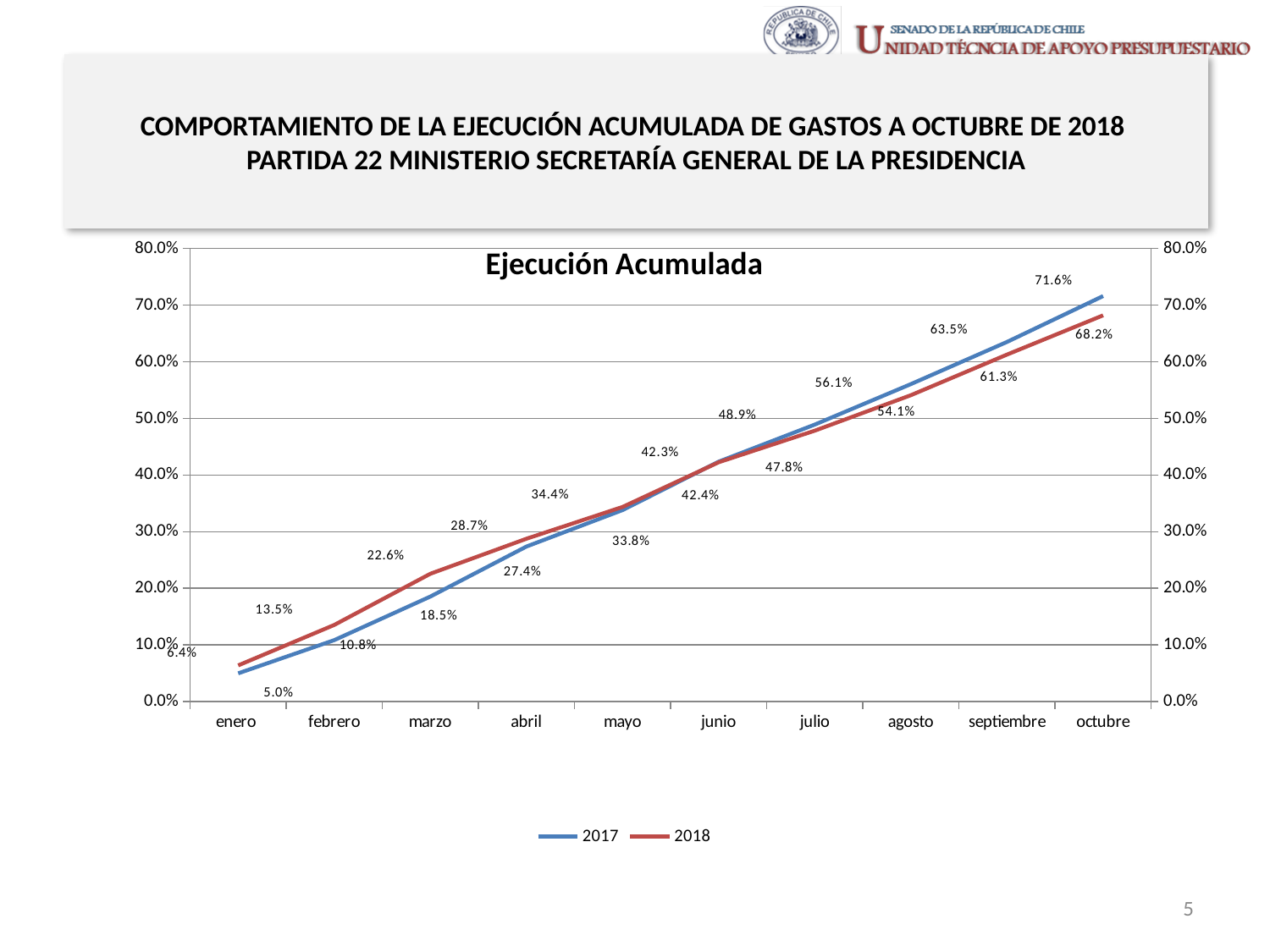
What is the lowest value labeled on the chart? 5.0% Is the value for 2017 in abril greater or less than 30%? less In enero, which series has the larger value, 2017 or 2018? 2018 How many months are plotted along the x axis? 10 How many series does the legend list? 2 What is the title of the chart? Ejecución Acumulada Which month has the lowest values for both series? enero Which series are listed in the legend? 2017 and 2018 What is the highest value labeled on the chart? 71.6% Which month has the highest values for both series? octubre What kind of chart is shown on the slide? line chart Do the values rise or fall from enero to octubre? rise